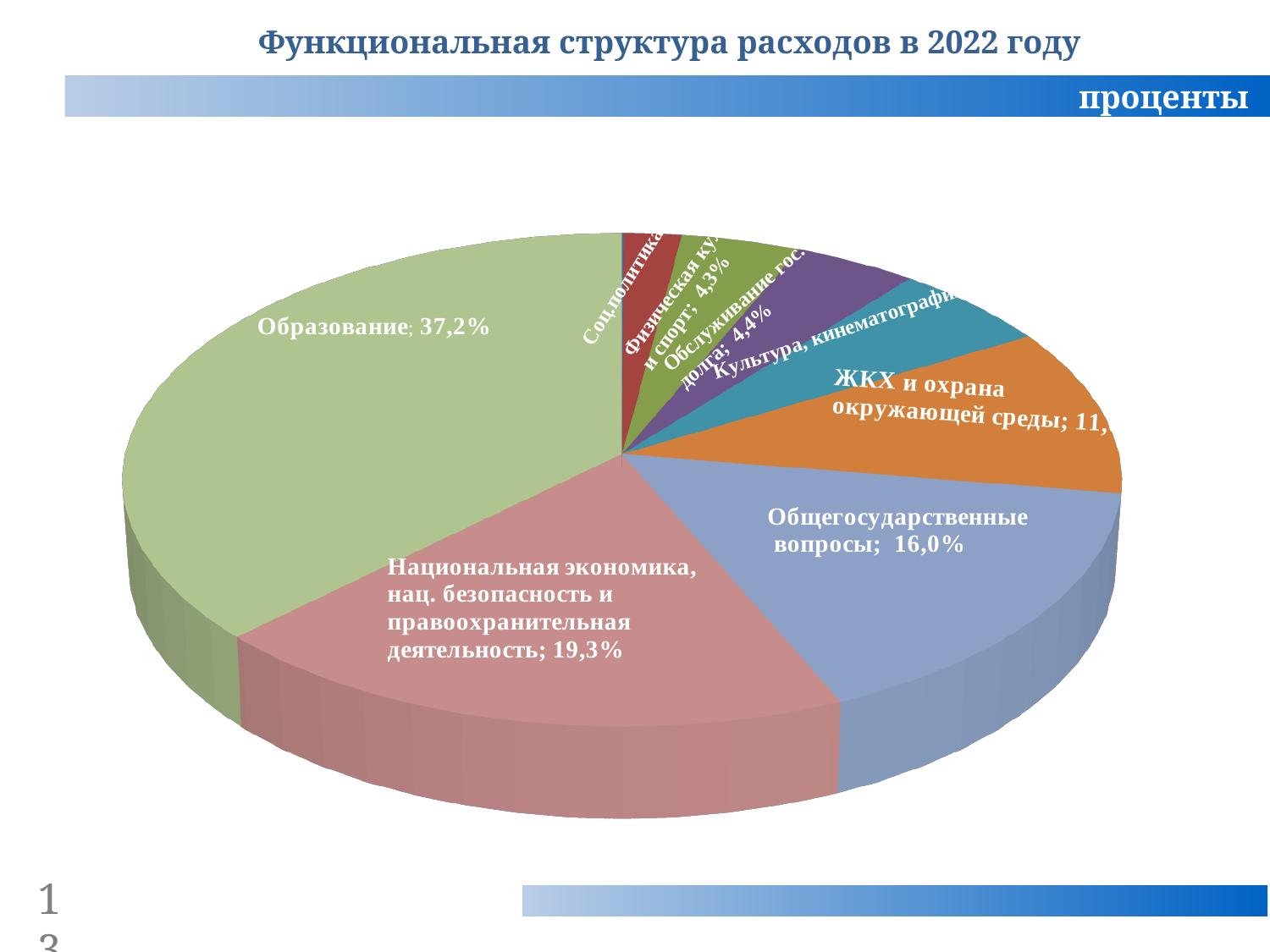
What is the difference between the shares of Образование and Национальная экономика, нац. безопасность и правоохранительная деятельность? 17,9% What is the value for Обслуживание гос. долга? 4,4% What share of expenditures does Образование account for? 37,2% What is the difference between the shares of Национальная экономика, нац. безопасность и правоохранительная деятельность and Общегосударственные вопросы? 3,3% What type of chart is shown on the slide? Pie chart What is the value for Физическая культура и спорт? 4,3% What is the value for Национальная экономика, нац. безопасность и правоохранительная деятельность? 19,3% Which is larger: the share of Общегосударственные вопросы or the share of Национальная экономика, нац. безопасность и правоохранительная деятельность? Национальная экономика, нац. безопасность и правоохранительная деятельность What is the value for Общегосударственные вопросы? 16,0% What is the title of the chart? Функциональная структура расходов в 2022 году Which category has the largest share of the pie? Образование